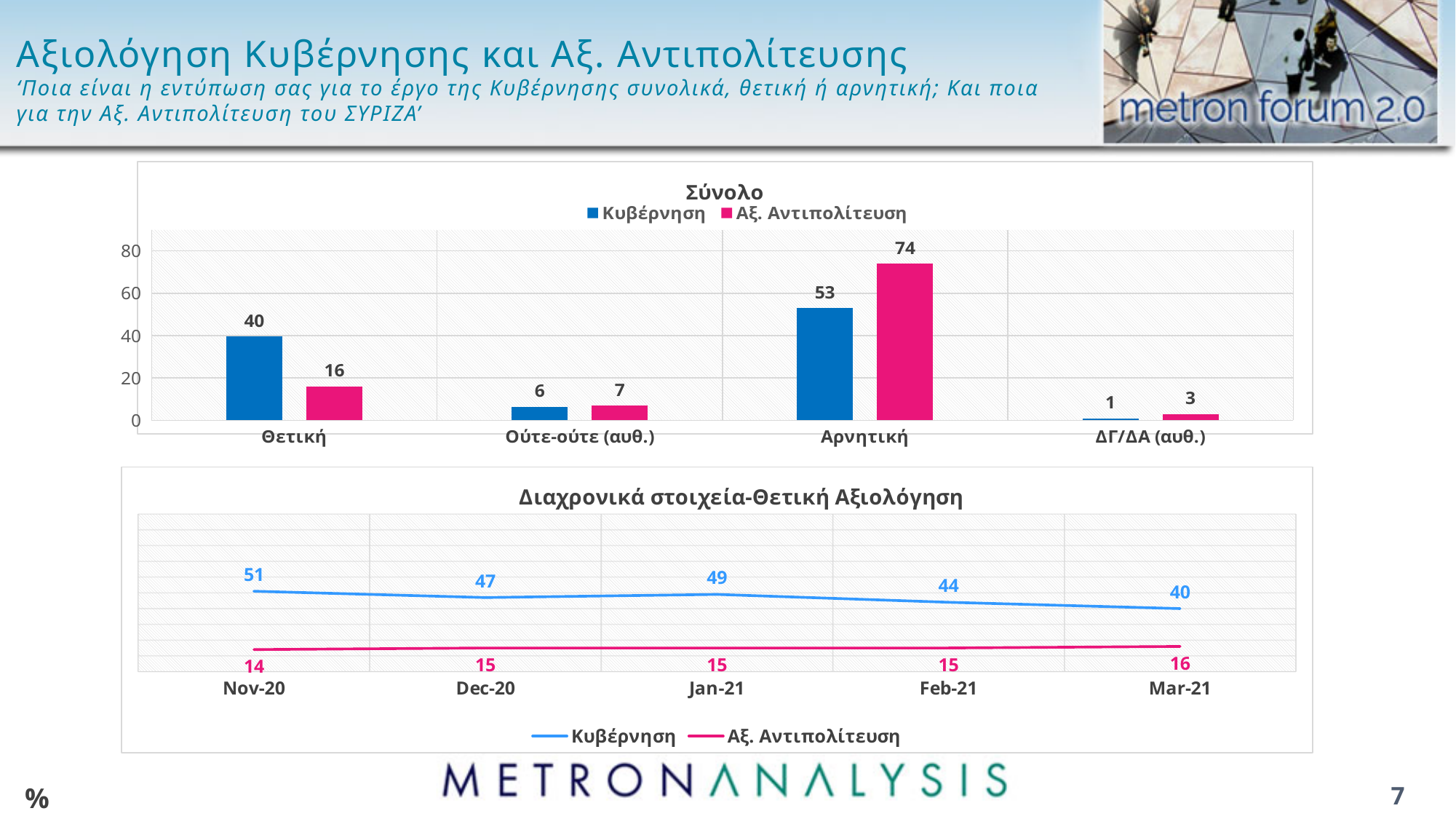
In the 'Σύνολο' chart, how many categories are shown on the x axis? 4 In the 'Διαχρονικά στοιχεία-Θετική Αξιολόγηση' chart, how many series does the legend list? 2 In the 'Διαχρονικά στοιχεία-Θετική Αξιολόγηση' chart, what is the difference between Κυβέρνηση and Αξ. Αντιπολίτευση in Mar-21? 24 In the 'Σύνολο' chart, which category has the lowest value for Αξ. Αντιπολίτευση? ΔΓ/ΔΑ (αυθ.) In the 'Σύνολο' chart, what is the value for Αξ. Αντιπολίτευση in the Αρνητική category? 74 In the 'Σύνολο' chart, which category has the highest value for Κυβέρνηση? Αρνητική In the 'Σύνολο' chart, what is the value for Κυβέρνηση in the Θετική category? 40 In the 'Διαχρονικά στοιχεία-Θετική Αξιολόγηση' chart, what is the value for Αξ. Αντιπολίτευση in Nov-20? 14 In the 'Διαχρονικά στοιχεία-Θετική Αξιολόγηση' chart, what is the value for Κυβέρνηση in Jan-21? 49 What kind of chart is the 'Σύνολο' chart? Bar chart In the 'Σύνολο' chart, what is the difference between Αξ. Αντιπολίτευση and Κυβέρνηση in the Αρνητική category? 21 In the 'Σύνολο' chart, which series has the larger value in the Θετική category? Κυβέρνηση